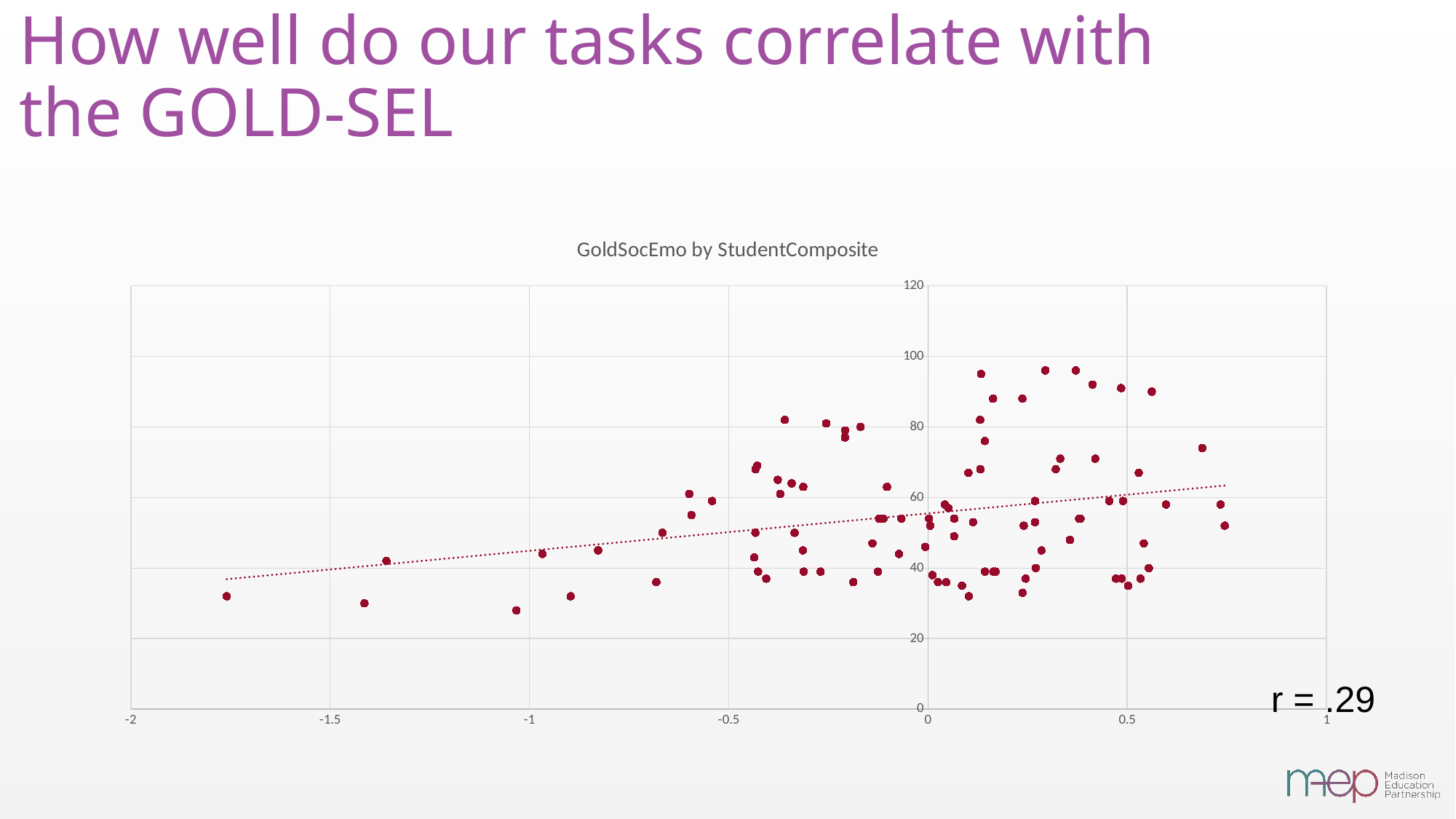
Is the lowest point on the chart greater or less than 20 on the y-axis? greater What correlation coefficient is printed next to the chart? r = .29 Are there more points to the right of 0 on the x-axis or to the left of -1? to the right of 0 What is the maximum value shown on the y-axis? 120 Is the rightmost point on the chart greater or less than 0.5 on the x-axis? greater Is the highest point on the chart greater or less than 100 on the y-axis? less What kind of chart is shown on the slide? scatter plot Does the dotted trend line rise or fall as the x-axis value increases? rises What is the title of the chart? GoldSocEmo by StudentComposite